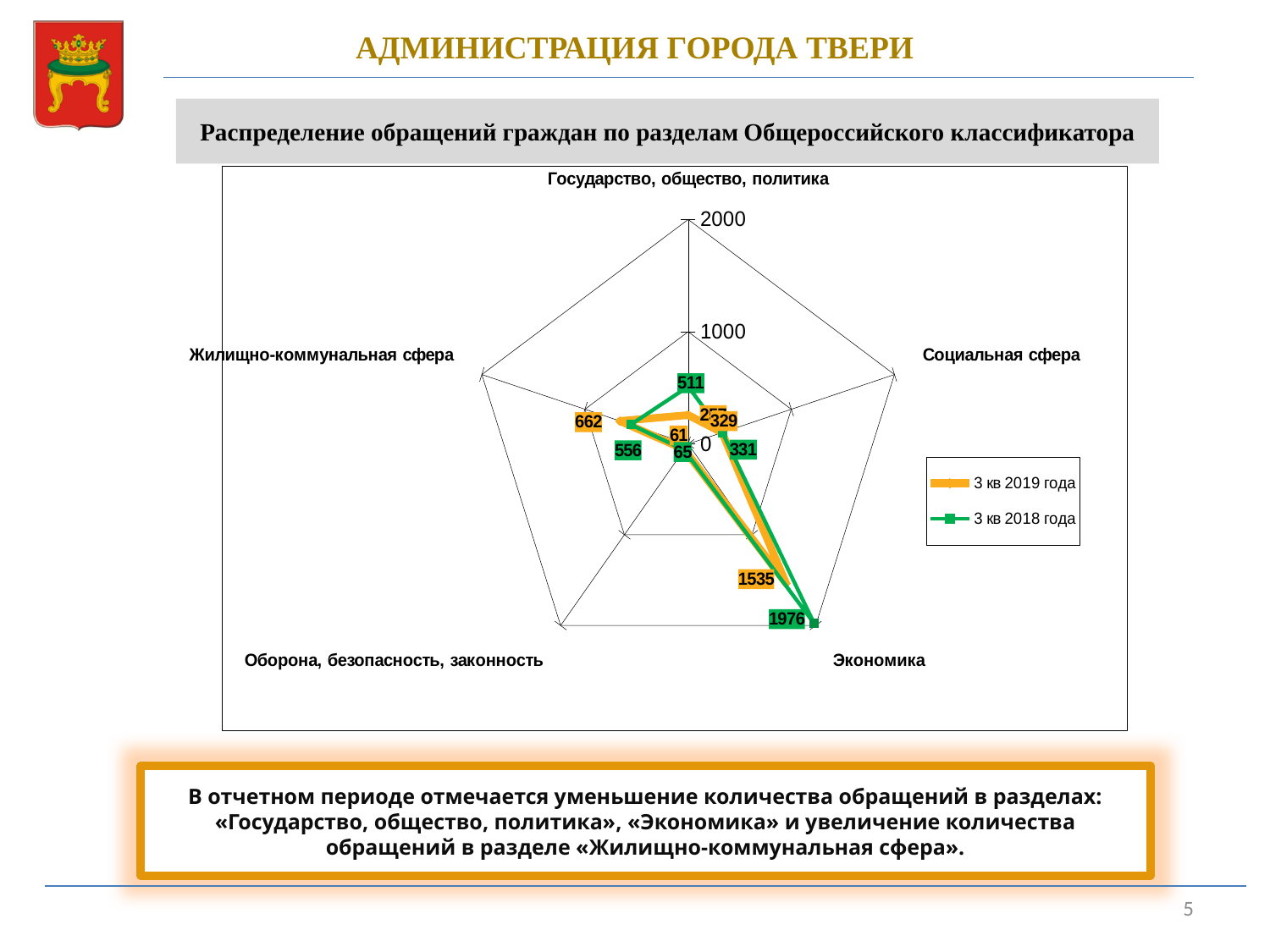
What is the value for Экономика in the series 3 кв 2019 года? 1535 How many categories (axes) does the radar chart have? 5 How many series does the legend list? 2 For Жилищно-коммунальная сфера, which series has the larger value: 3 кв 2019 года or 3 кв 2018 года? 3 кв 2019 года What kind of chart is shown on the slide? Radar chart What is the value for Экономика in the series 3 кв 2018 года? 1976 Which category has the lowest value in the series 3 кв 2019 года? Оборона, безопасность, законность Is the value for Экономика in the series 3 кв 2019 года greater or less than 1000? greater What is the value for Государство, общество, политика in the series 3 кв 2018 года? 511 What is the value for Жилищно-коммунальная сфера in the series 3 кв 2019 года? 662 What is the difference between the 3 кв 2018 года and 3 кв 2019 года values for Экономика? 441 Which category has the highest value in the series 3 кв 2018 года? Экономика